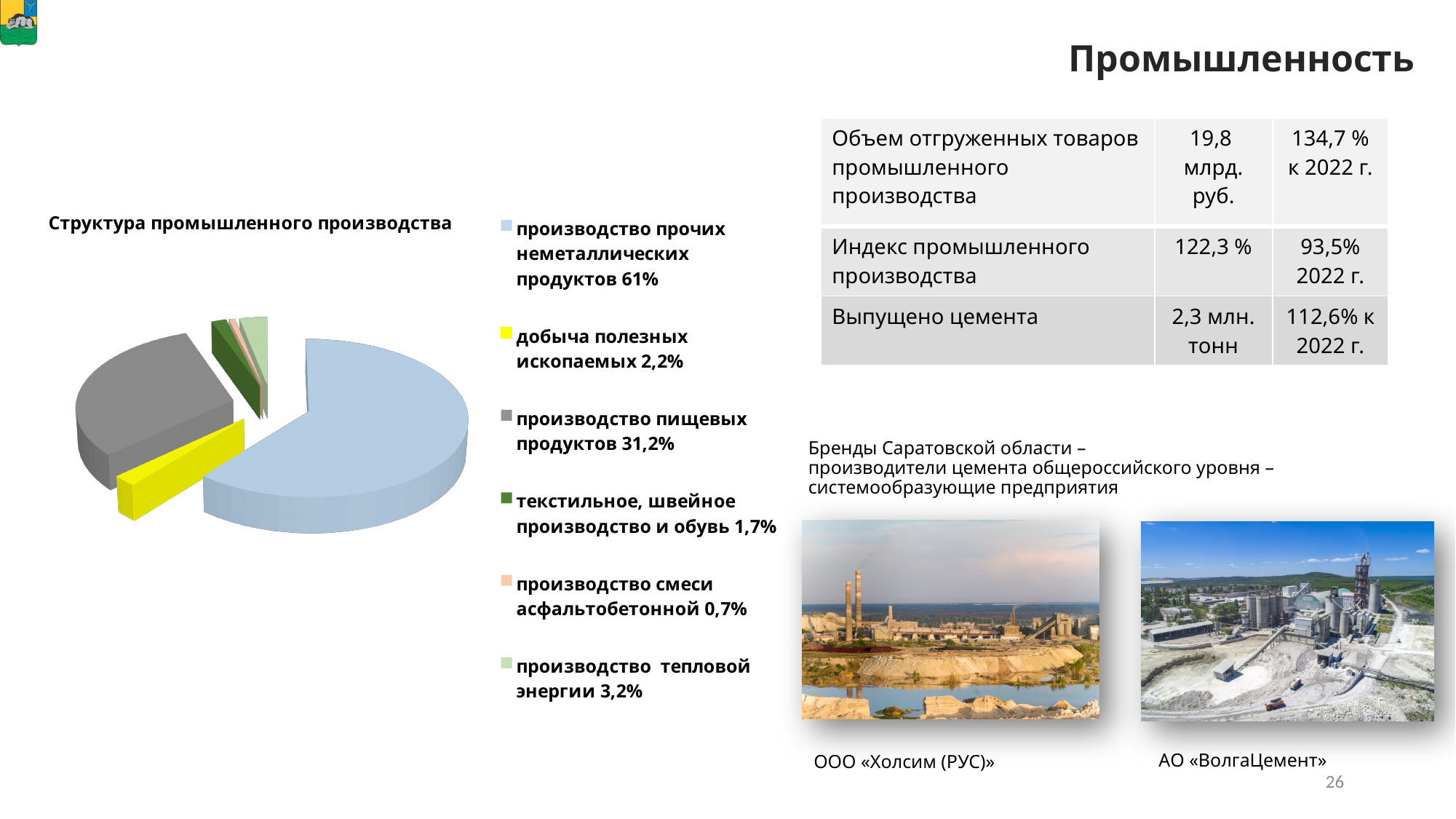
Which category has the largest slice in the pie chart? производство прочих неметаллических продуктов Which category has the smallest slice in the pie chart? производство смеси асфальтобетонной What is the value for «добыча полезных ископаемых» in the pie chart? 2,2% Which is larger in the pie chart: «добыча полезных ископаемых» or «текстильное, швейное производство и обувь»? добыча полезных ископаемых How many categories does the pie chart «Структура промышленного производства» show? 6 Which is larger in the pie chart: «производство тепловой энергии» or «производство смеси асфальтобетонной»? производство тепловой энергии What type of chart is shown under the title «Структура промышленного производства»? Pie chart What share of the pie chart does «производство прочих неметаллических продуктов» have? 61% What is the value for «производство тепловой энергии» in the pie chart? 3,2% What colour is the slice for «добыча полезных ископаемых» in the pie chart? Yellow What is the difference in percentage points between «производство прочих неметаллических продуктов» and «производство пищевых продуктов»? 29,8 What is the value for «производство пищевых продуктов» in the pie chart? 31,2%